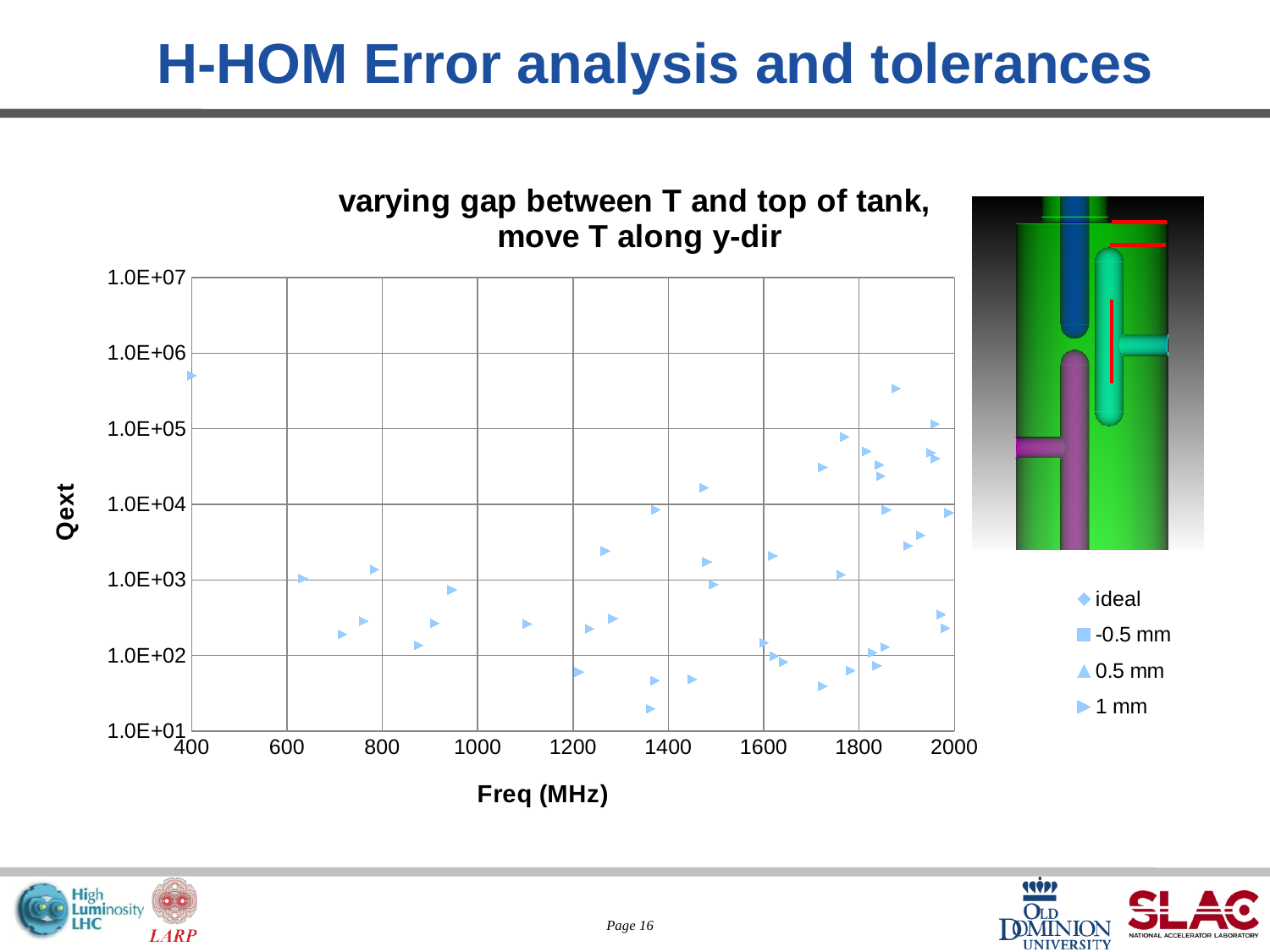
Is the Qext value of the point plotted at about 400 MHz greater or less than 1.0E+05? greater What are the four entries listed in the chart legend? ideal, -0.5 mm, 0.5 mm, 1 mm What kind of chart is shown on the slide? scatter chart How many series does the chart legend list? 4 What is the title of the chart? varying gap between T and top of tank, move T along y-dir Is the lowest plotted Qext value on the chart greater or less than 1.0E+02? less Is the highest plotted Qext value on the chart greater or less than 1.0E+05? greater